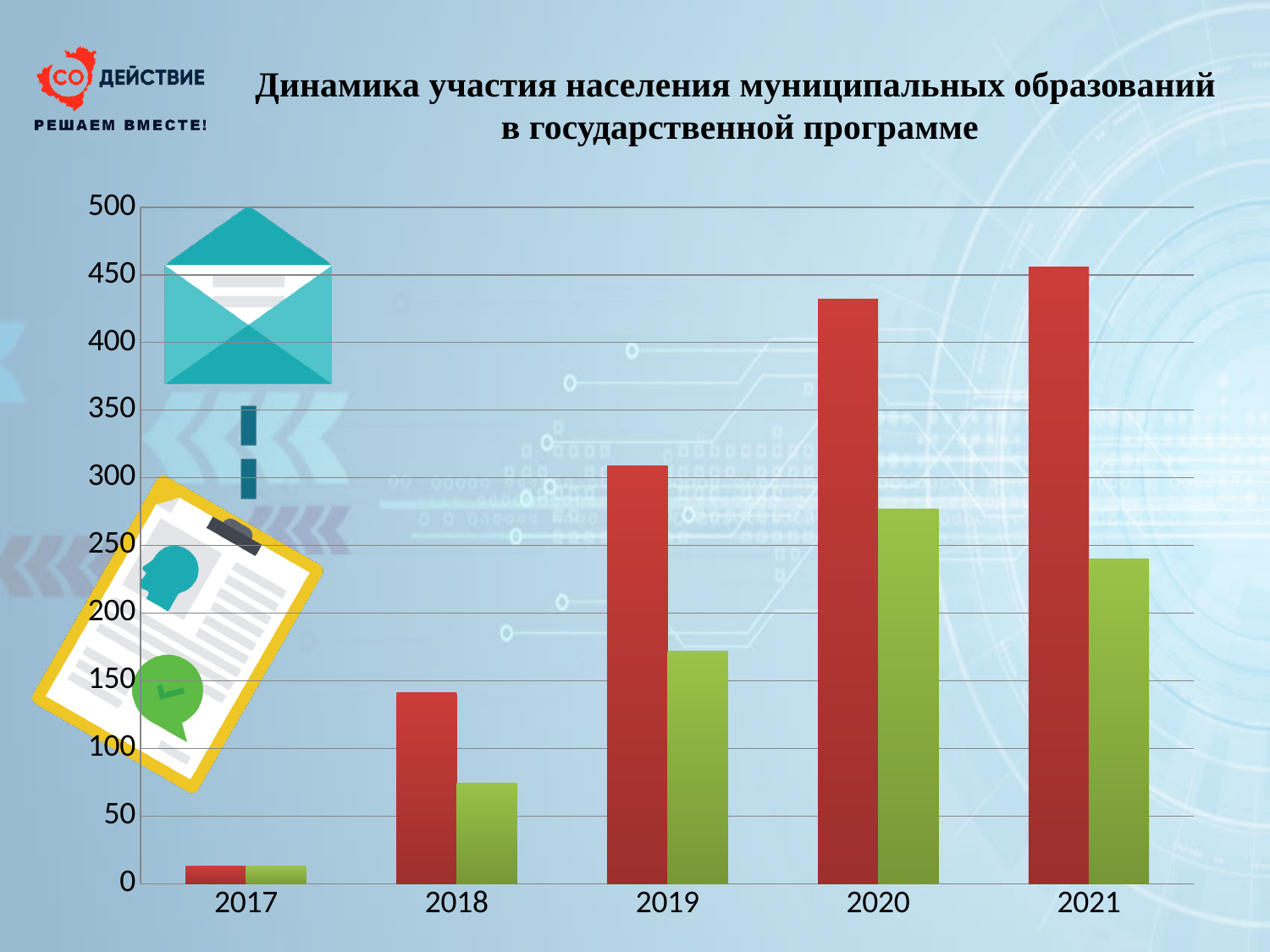
In 2021, which bar is taller, the red one or the green one? the red one Is the green bar for 2018 greater or less than 100? less Is the green bar for 2020 taller or shorter than the green bar for 2021? taller Is the red bar for 2018 greater or less than 100? greater What kind of chart is shown on the slide? bar chart Which year has the tallest red bar? 2021 Which year has the tallest green bar? 2020 Which year has the lowest red bar? 2017 Is the green bar for 2020 greater or less than 250? greater Do the red bars rise or fall from 2017 to 2021? rise How many years are shown on the x axis of the chart? 5